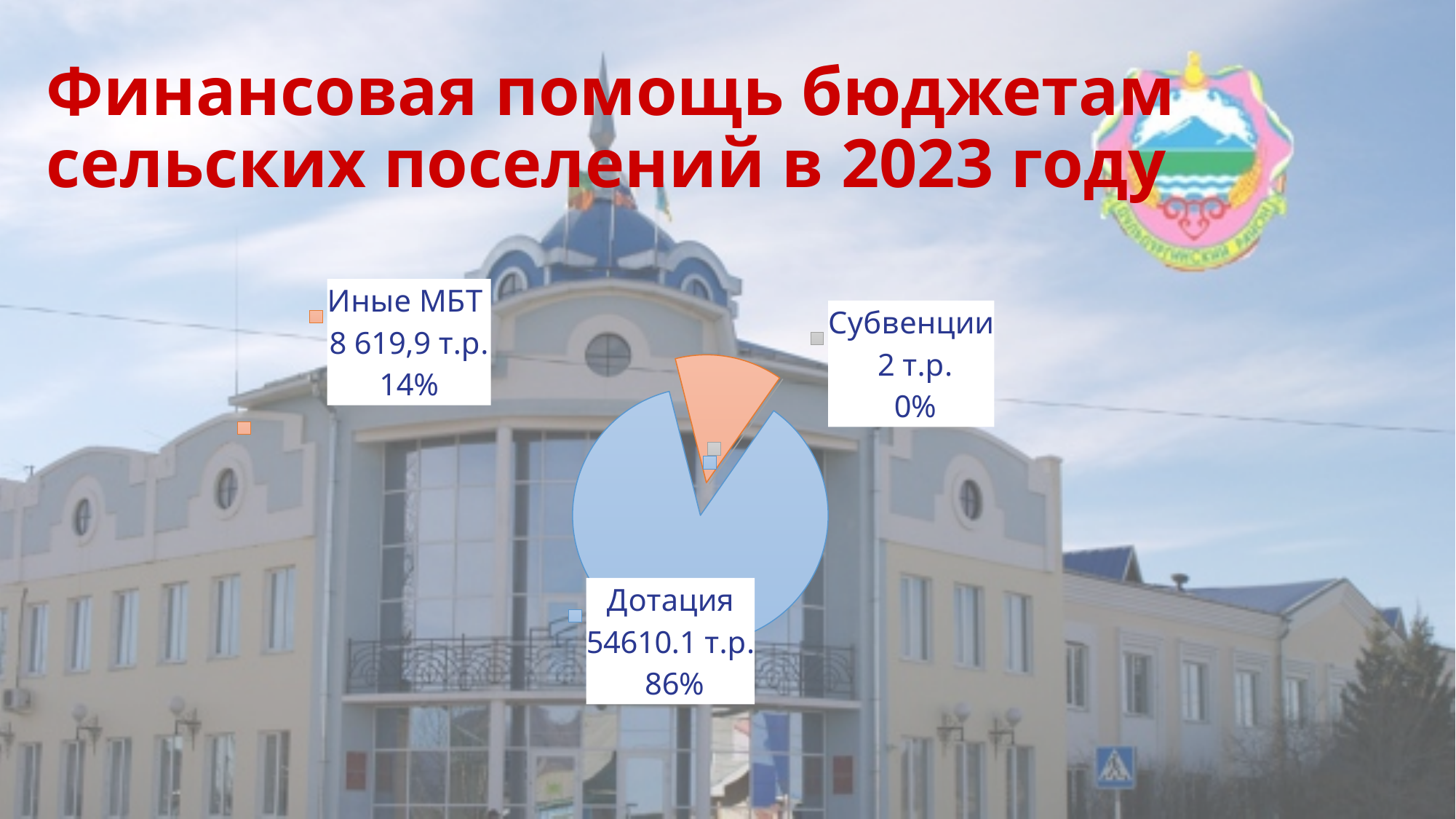
Which category has the smallest slice of the pie? Субвенции How many categories are shown in the pie chart? 3 What share of the pie does Субвенции represent? 0% What is the value shown for Субвенции? 2 т.р. What is the title of the slide containing the chart? Финансовая помощь бюджетам сельских поселений в 2023 году What kind of chart is shown on the slide? pie chart What is the value shown for Иные МБТ? 8 619,9 т.р. Which category has the largest slice of the pie? Дотация What share of the pie does Дотация represent? 86% What share of the pie does Иные МБТ represent? 14% Which is larger, Иные МБТ or Субвенции? Иные МБТ What is the value shown for Дотация? 54610.1 т.р.